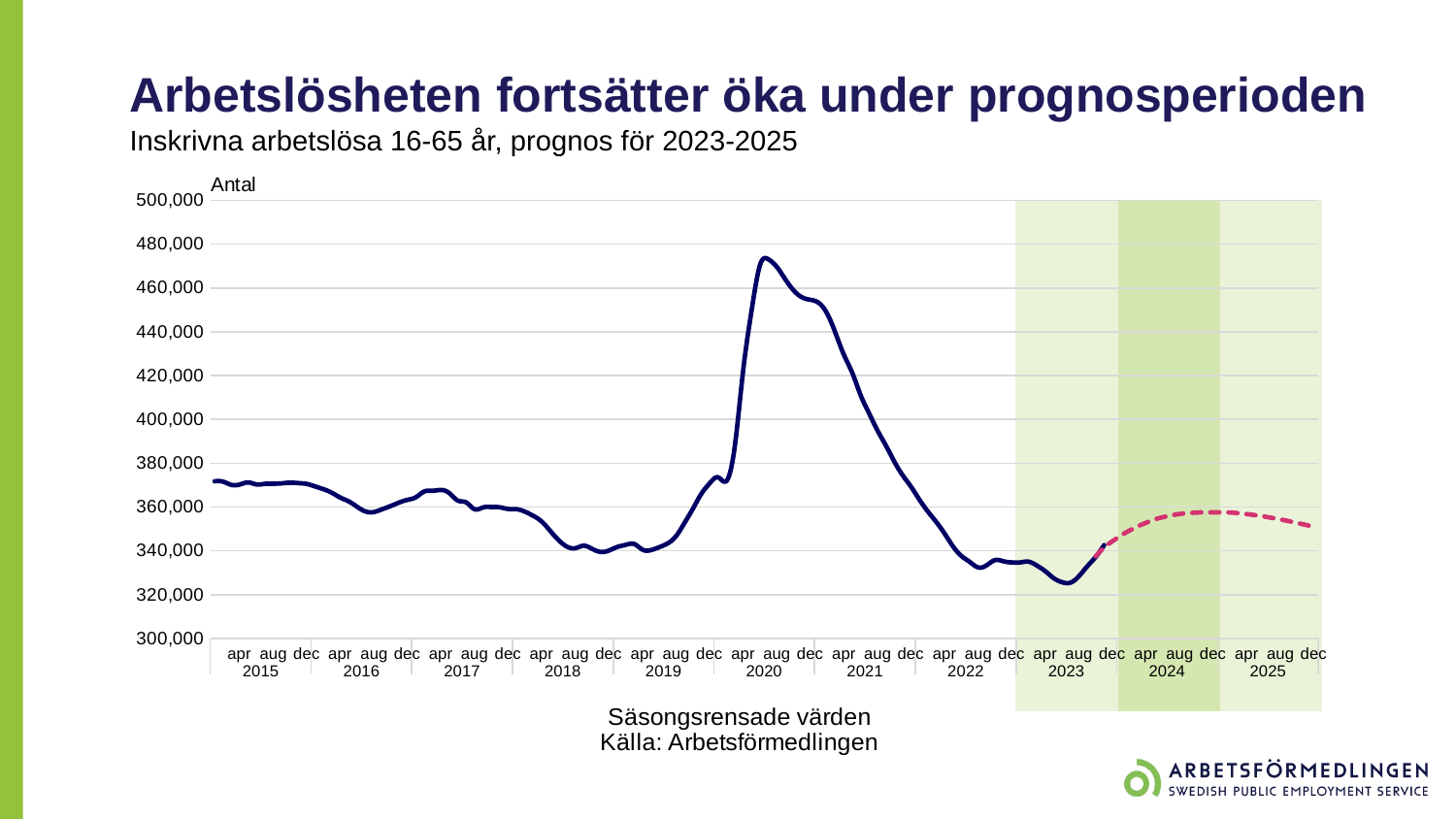
Is the peak value in 2020 greater or less than 460,000? greater Is the lowest value in early 2023 greater or less than 340,000? less What is the title of the chart on the slide? Arbetslösheten fortsätter öka under prognosperioden In which year does the line reach its lowest value? 2023 Does the line rise or fall between the 2020 peak and the end of 2022? fall In which year does the line reach its highest value? 2020 What kind of chart is shown on the slide? line chart How many years are labelled along the x axis of the chart? 11 What label is shown on the vertical axis of the chart? Antal Is the value at the start of 2015 greater or less than 360,000? greater Does the dashed forecast line rise or fall from the start of 2023 to mid-2024? rise